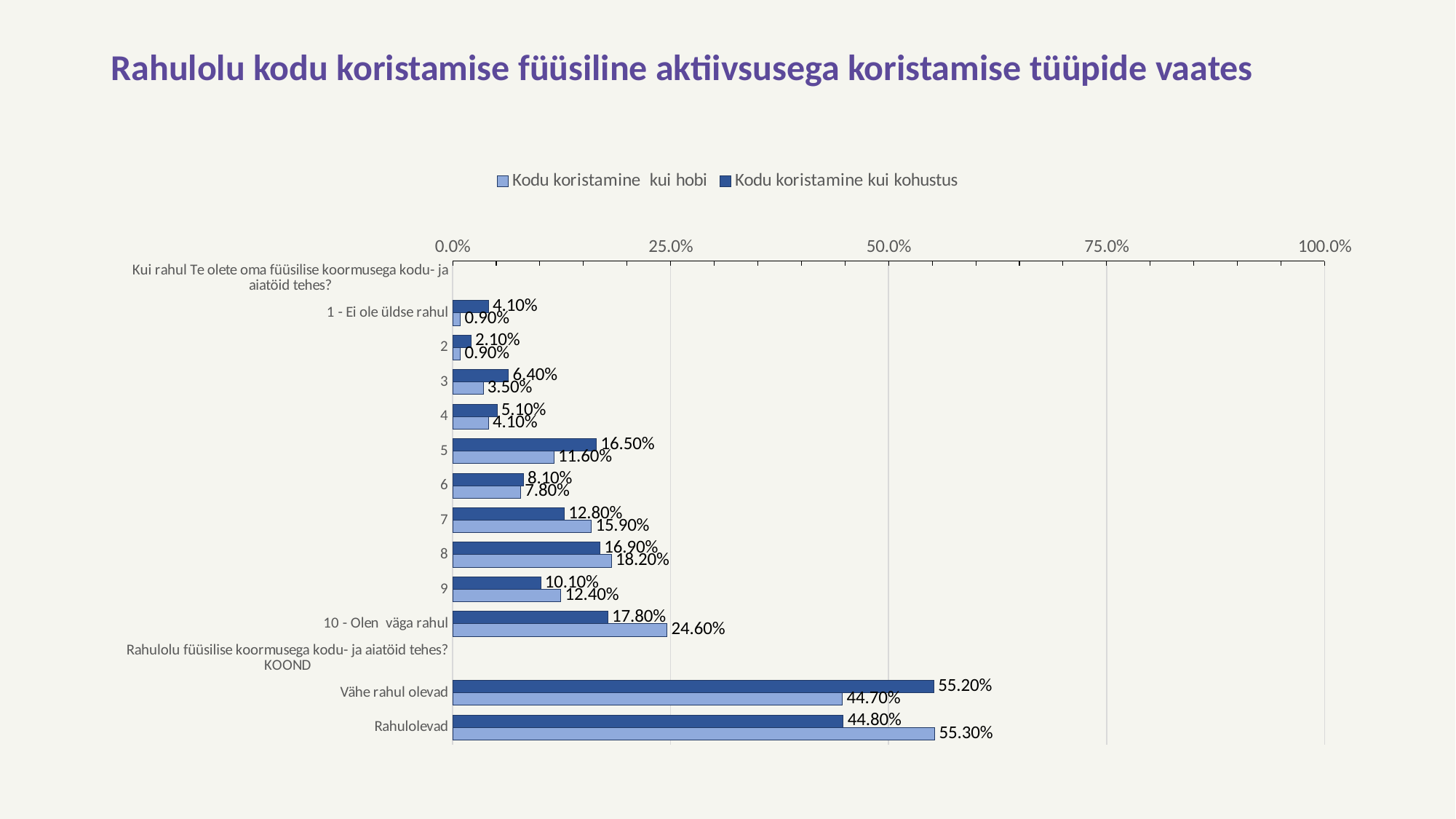
What is the value for "Kodu koristamine kui hobi" at category 5? 11.60% What kind of chart is shown on the slide? Bar chart How many series does the legend list? 2 At category 7, which series has the larger value: "Kodu koristamine kui hobi" or "Kodu koristamine kui kohustus"? Kodu koristamine kui hobi What is the title of the slide? Rahulolu kodu koristamise füüsiline aktiivsusega koristamise tüüpide vaates Among the categories 1 through 10, which has the highest value for "Kodu koristamine kui kohustus"? 10 - Olen väga rahul What is the difference between "Kodu koristamine kui hobi" and "Kodu koristamine kui kohustus" at "Rahulolevad"? 10.50% What is the value for "Kodu koristamine kui kohustus" at category 8? 16.90% What is the value for "Kodu koristamine kui kohustus" at "Vähe rahul olevad"? 55.20% Which category has the lowest value for "Kodu koristamine kui kohustus"? 2 What is the value for "Kodu koristamine kui hobi" at "10 - Olen väga rahul"? 24.60% Is the value for "Kodu koristamine kui hobi" at "Rahulolevad" greater or less than 50.0%? greater